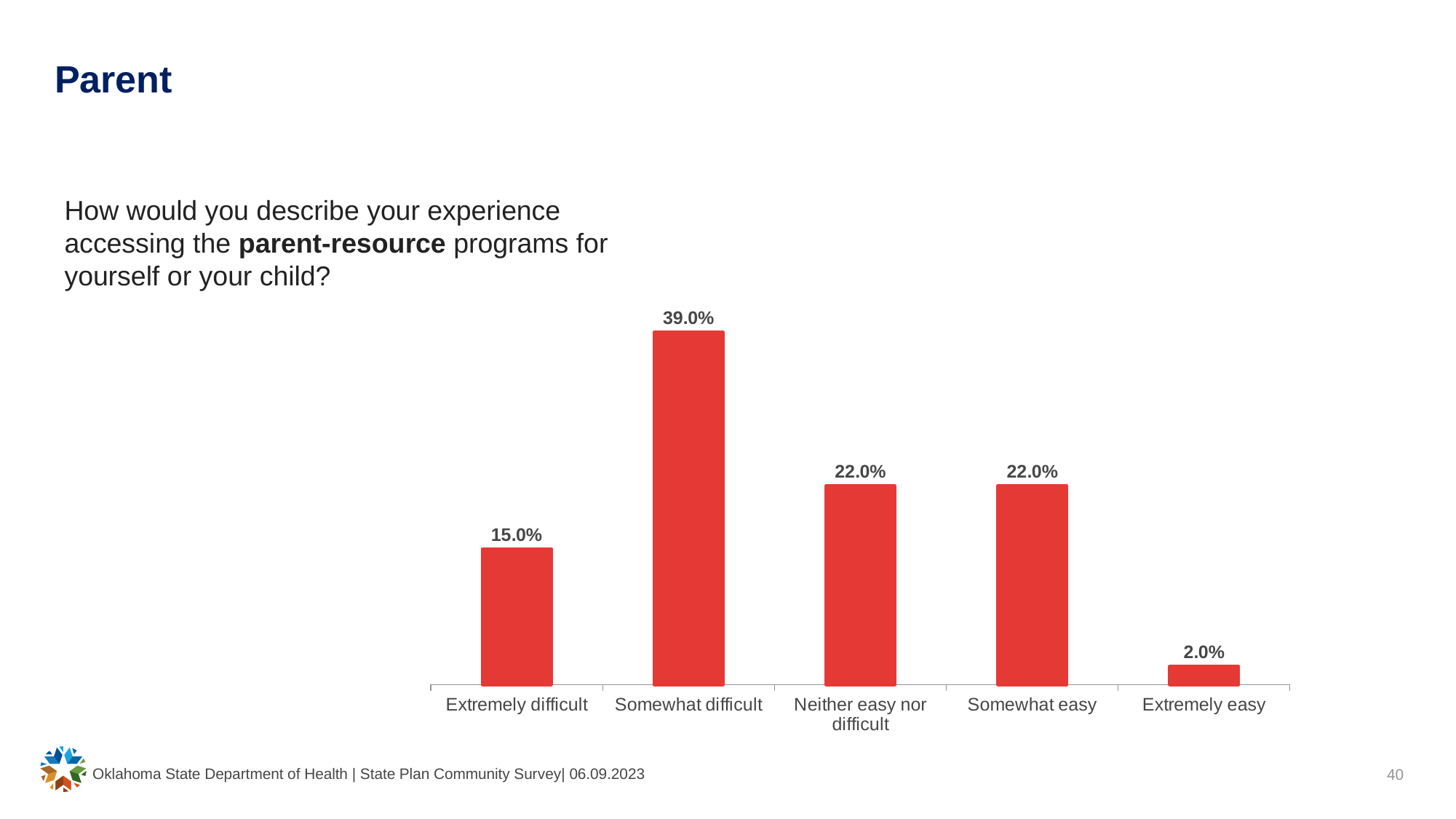
Which category has the highest value? Somewhat difficult What colour are the bars in the chart? Red What kind of chart is shown on the slide? Bar chart How many categories are shown on the x axis? 5 Which category has the lowest value? Extremely easy What is the value for Extremely easy? 2.0% Which is larger, the value for Extremely difficult or the value for Somewhat easy? Somewhat easy What is the value for Extremely difficult? 15.0% What is the difference between the values for Somewhat easy and Extremely easy? 20.0% What is the difference between the values for Somewhat difficult and Extremely difficult? 24.0% What is the value for Neither easy nor difficult? 22.0% What percentage of parents described accessing parent-resource programs as Somewhat difficult? 39.0%